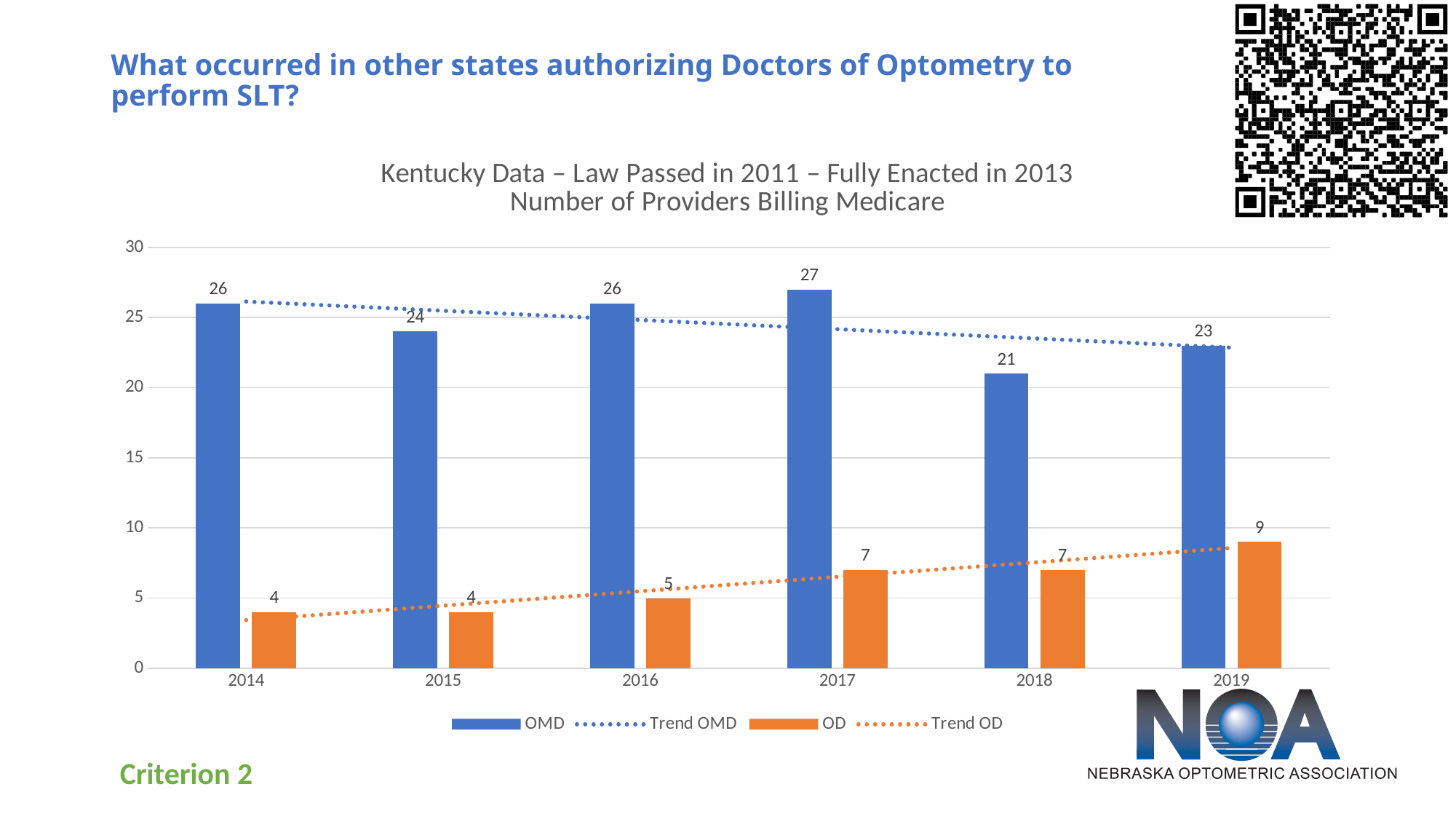
What is the OMD value for 2018? 21 In which year is the OMD value lowest? 2018 What kind of chart is shown on the slide? Bar chart with trend lines What is the OMD value for 2017? 27 How many years are shown on the x axis? 6 Which is larger, the OD value in 2016 or the OD value in 2018? 2018 In which year is the OD value highest? 2019 What is the OD value for 2019? 9 How many entries does the legend list? 4 What is the difference between the OMD and OD values in 2014? 22 In which year is the OMD value highest? 2017 Does the OD trend line rise or fall from 2014 to 2019? Rise